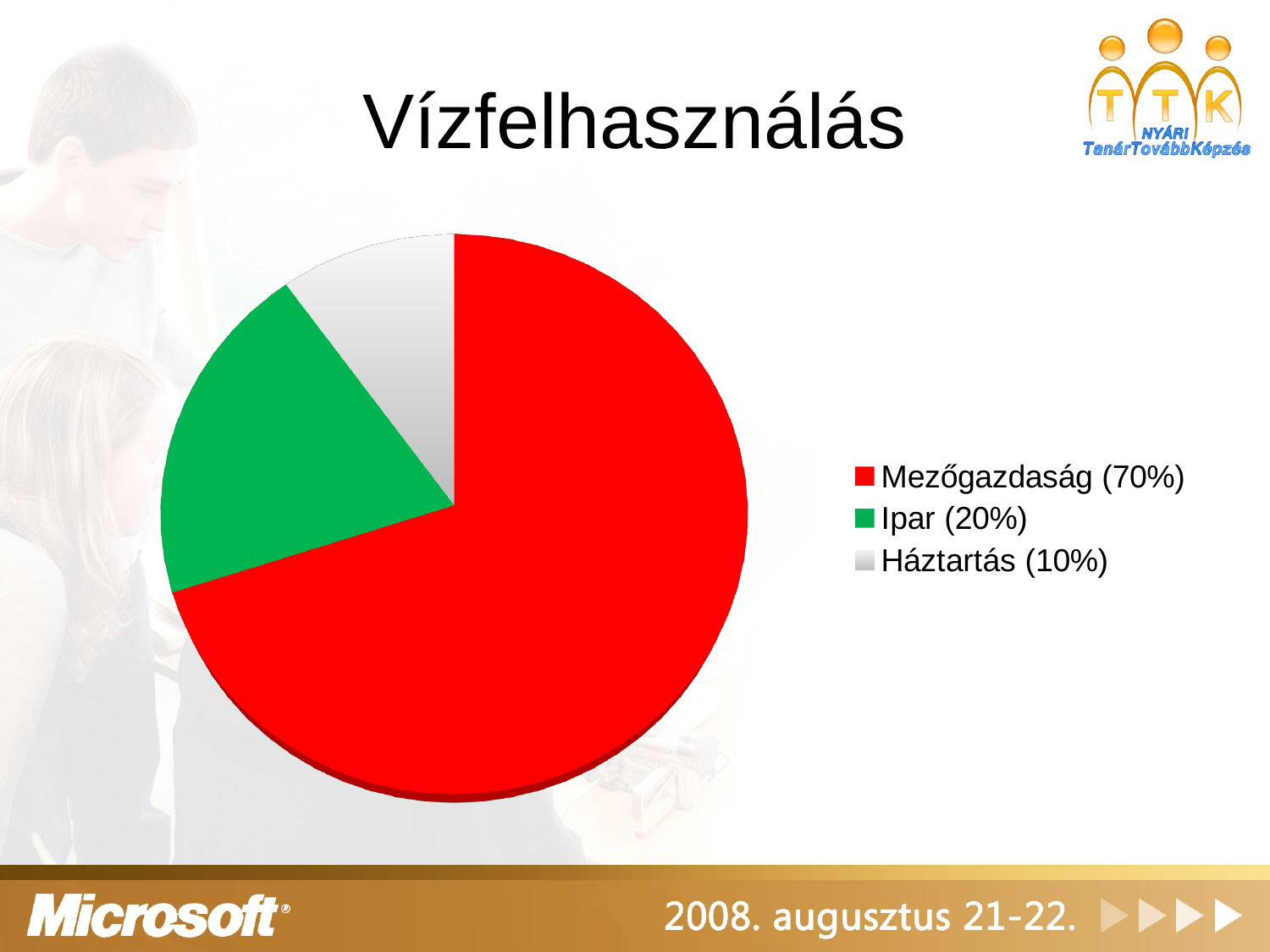
What is the title of the chart on the slide? Vízfelhasználás What is the difference in percentage points between Mezőgazdaság and Ipar? 50 What kind of chart is shown on the slide? pie chart Which is larger, the share for Ipar or the share for Háztartás? Ipar Which category has the smallest slice of the pie? Háztartás What colour is the slice for Ipar? green What is the difference in percentage points between Ipar and Háztartás? 10 Which category has the largest slice of the pie? Mezőgazdaság What share of the pie does Ipar have? 20% What share of the pie does Mezőgazdaság have? 70% How many slices does the pie chart have? 3 What share of the pie does Háztartás have? 10%